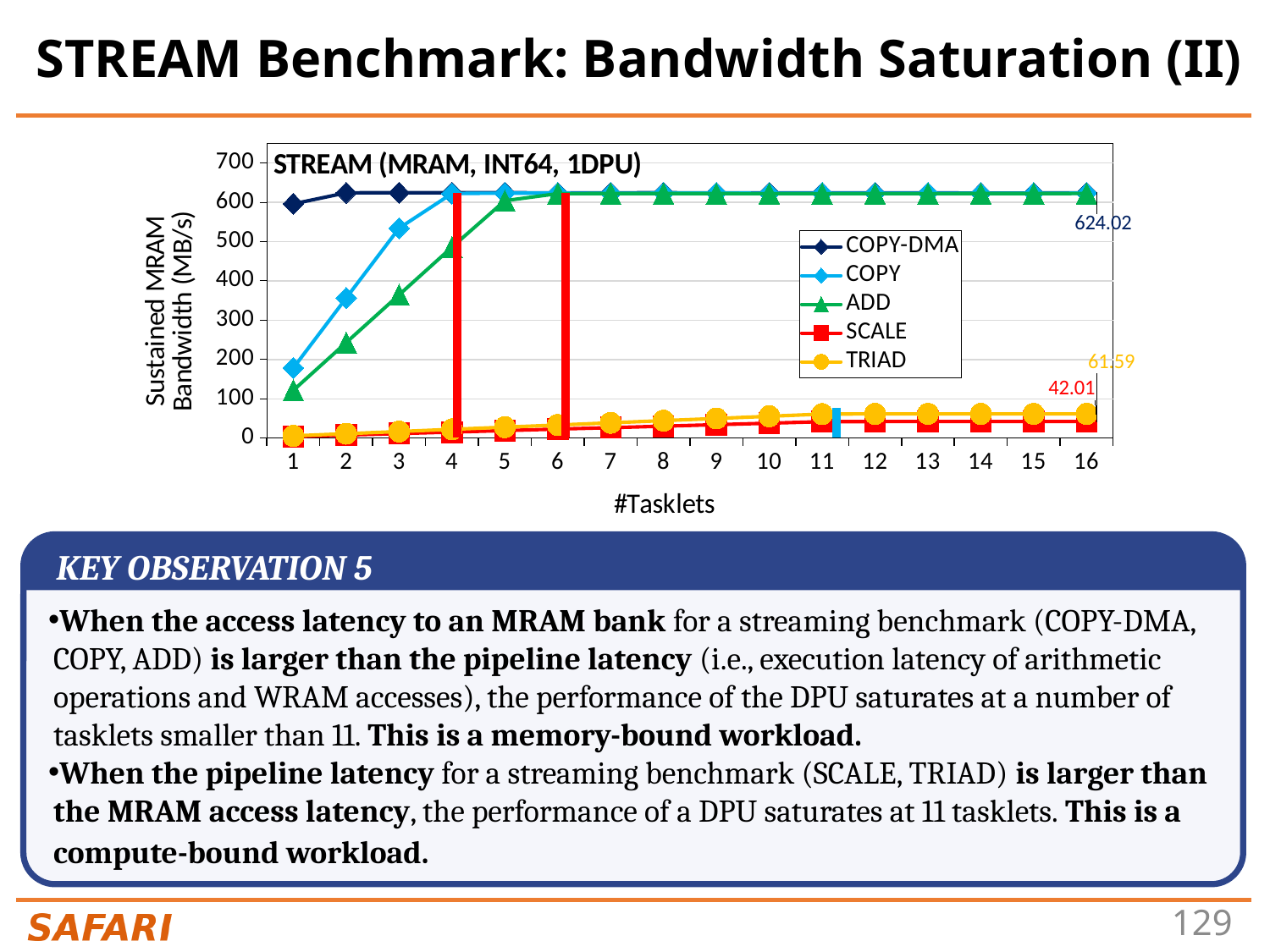
Which series has the highest bandwidth at 1 tasklet? COPY-DMA What is the labelled sustained MRAM bandwidth for TRIAD at 16 tasklets? 61.59 Is the COPY-DMA value at 1 tasklet greater or less than 500? greater How many #Tasklets values are plotted along the x axis? 16 What is the difference between the labelled TRIAD and SCALE values at 16 tasklets? 19.58 Does the COPY bandwidth rise or fall as the number of tasklets increases from 1 to 4? rise What is the labelled sustained MRAM bandwidth for COPY-DMA at 16 tasklets? 624.02 What is the title shown inside the chart area? STREAM (MRAM, INT64, 1DPU) How many series does the chart legend list? 5 At 16 tasklets, which has the higher bandwidth, TRIAD or SCALE? TRIAD What kind of chart is shown on the slide? line chart What is the labelled sustained MRAM bandwidth for SCALE at 16 tasklets? 42.01